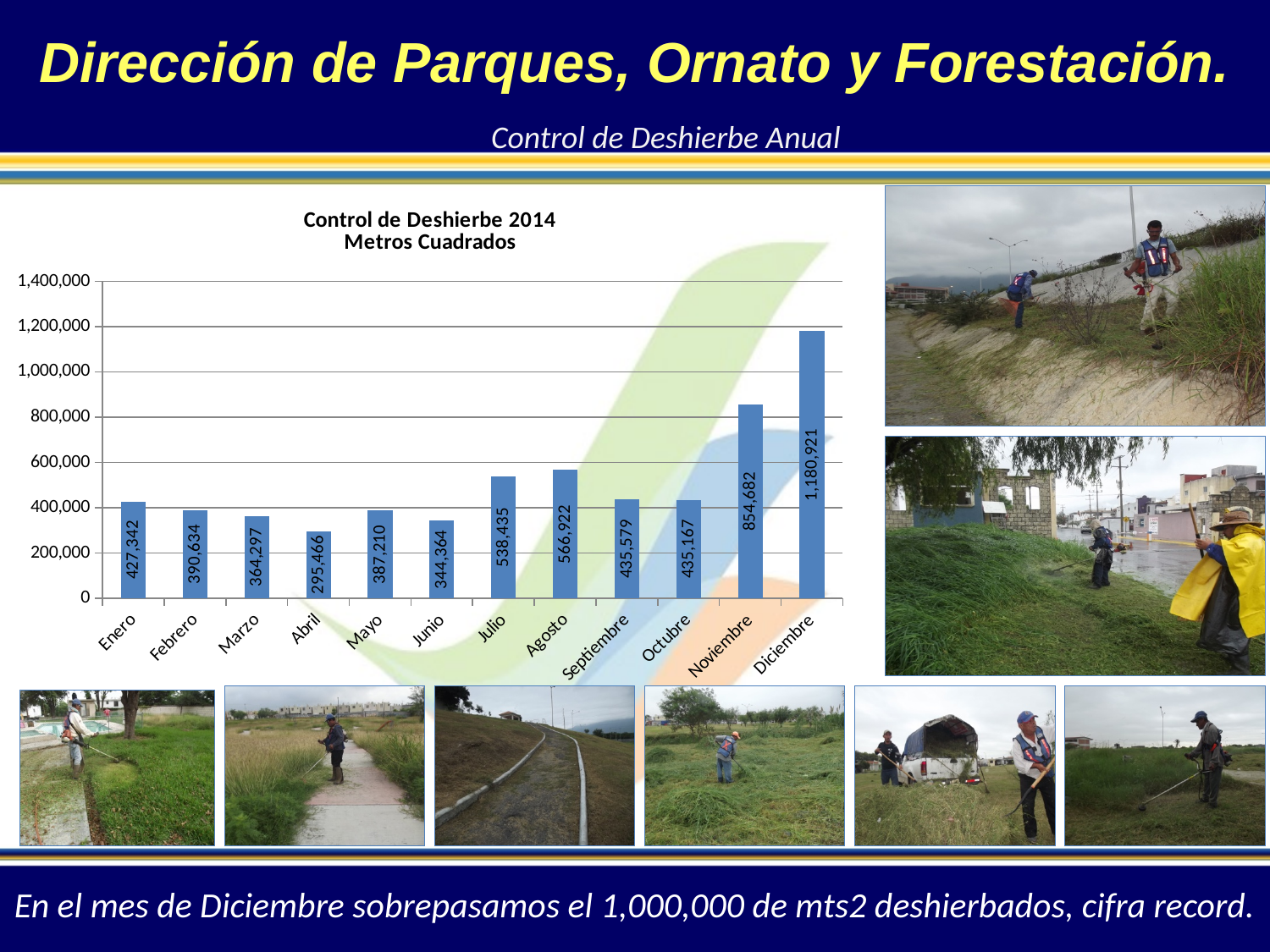
How many months are shown on the x axis of the chart? 12 What kind of chart is shown on the slide? bar chart What is the value for Diciembre in the chart? 1,180,921 What is the title of the chart? Control de Deshierbe 2014 Metros Cuadrados Which is larger, the value for Enero or the value for Febrero? Enero What is the difference between the values for Diciembre and Noviembre? 326,239 What is the value for Abril in the chart? 295,466 Is the value for Noviembre greater or less than 1,000,000? less What is the value for Noviembre in the chart? 854,682 Which month has the lowest value in the chart? Abril Which month has the highest value in the chart? Diciembre What is the difference between the values for Agosto and Julio? 28,487